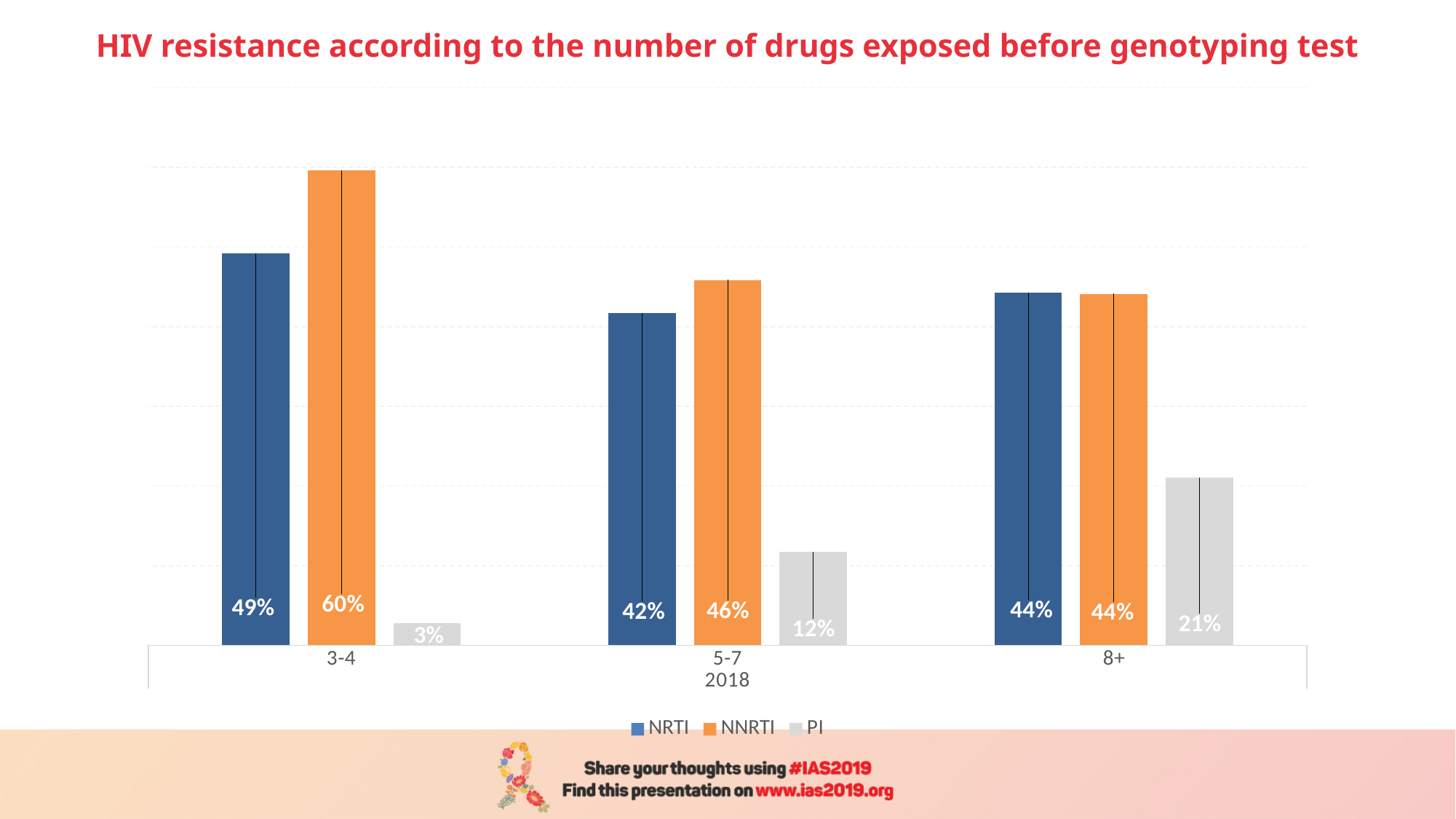
What is the NNRTI resistance value for the 5-7 drugs category? 46% What is the PI resistance value for the 8+ drugs category? 21% How many series does the legend list? 3 Which category has the highest PI resistance value? 8+ What is the difference between the NNRTI and NRTI values in the 3-4 drugs category? 11% What kind of chart is shown on the slide? Bar chart What is the difference between the PI values for the 8+ and 3-4 categories? 18% Which is larger in the 5-7 drugs category, NRTI or NNRTI resistance? NNRTI What is the NRTI resistance value for the 3-4 drugs category? 49% Do the PI resistance values rise or fall as the number of drugs exposed increases? Rise Which category has the lowest NNRTI resistance value? 8+ How many drug-exposure categories are shown on the x axis? 3